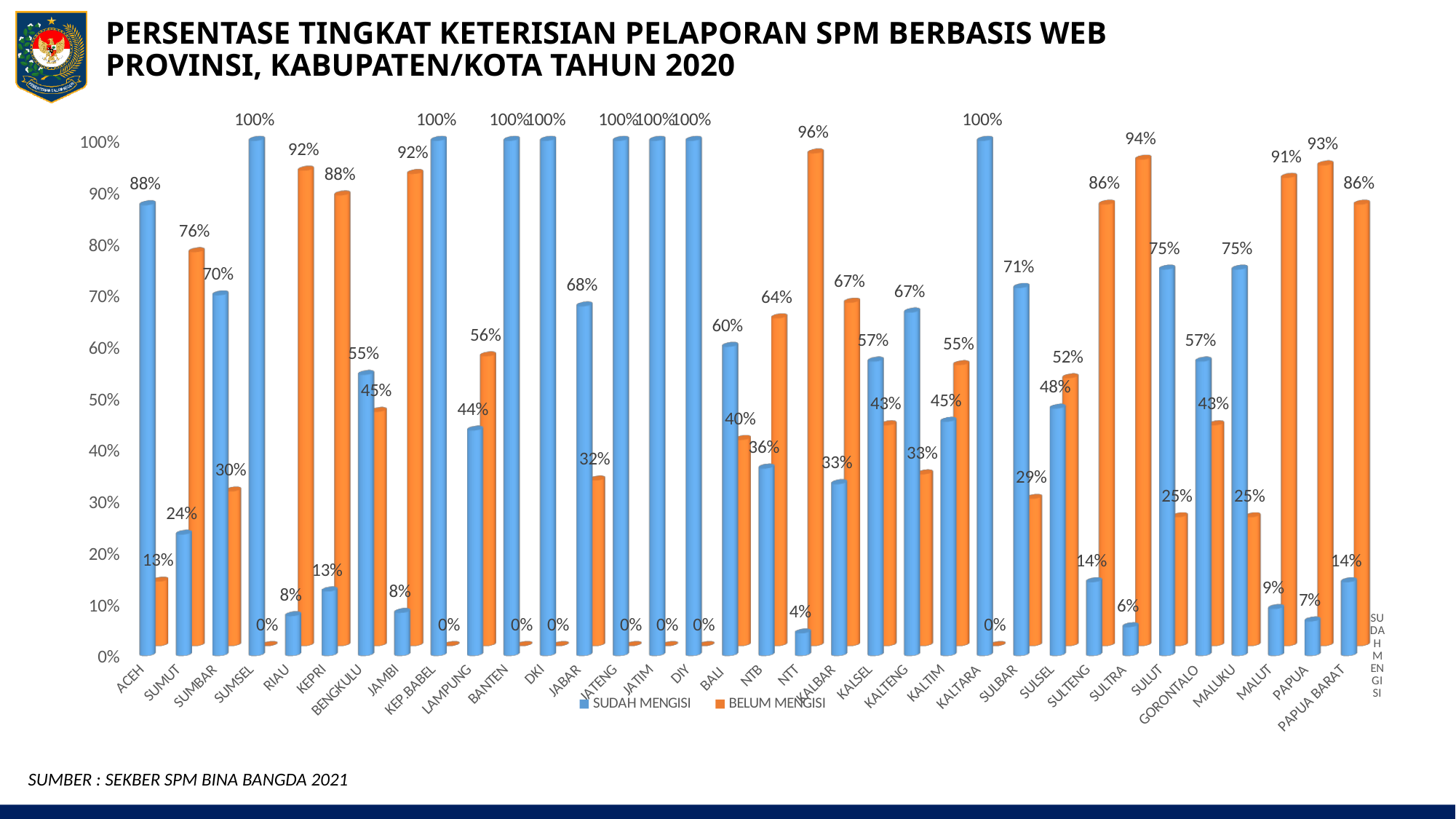
Which province has the lowest SUDAH MENGISI value? NTT What is the difference between the SUDAH MENGISI and BELUM MENGISI values for SUMUT? 52% How many provinces are shown on the x axis? 34 Which province has the highest BELUM MENGISI value? NTT What kind of chart is shown on the slide? Bar chart What is the BELUM MENGISI value for SULTRA? 94% What is the SUDAH MENGISI value for SULBAR? 71% What is the BELUM MENGISI value for NTT? 96% What is the SUDAH MENGISI value for ACEH? 88% How many series does the legend list? 2 Which series is shown in orange? BELUM MENGISI Which is larger for KALTENG: SUDAH MENGISI or BELUM MENGISI? SUDAH MENGISI